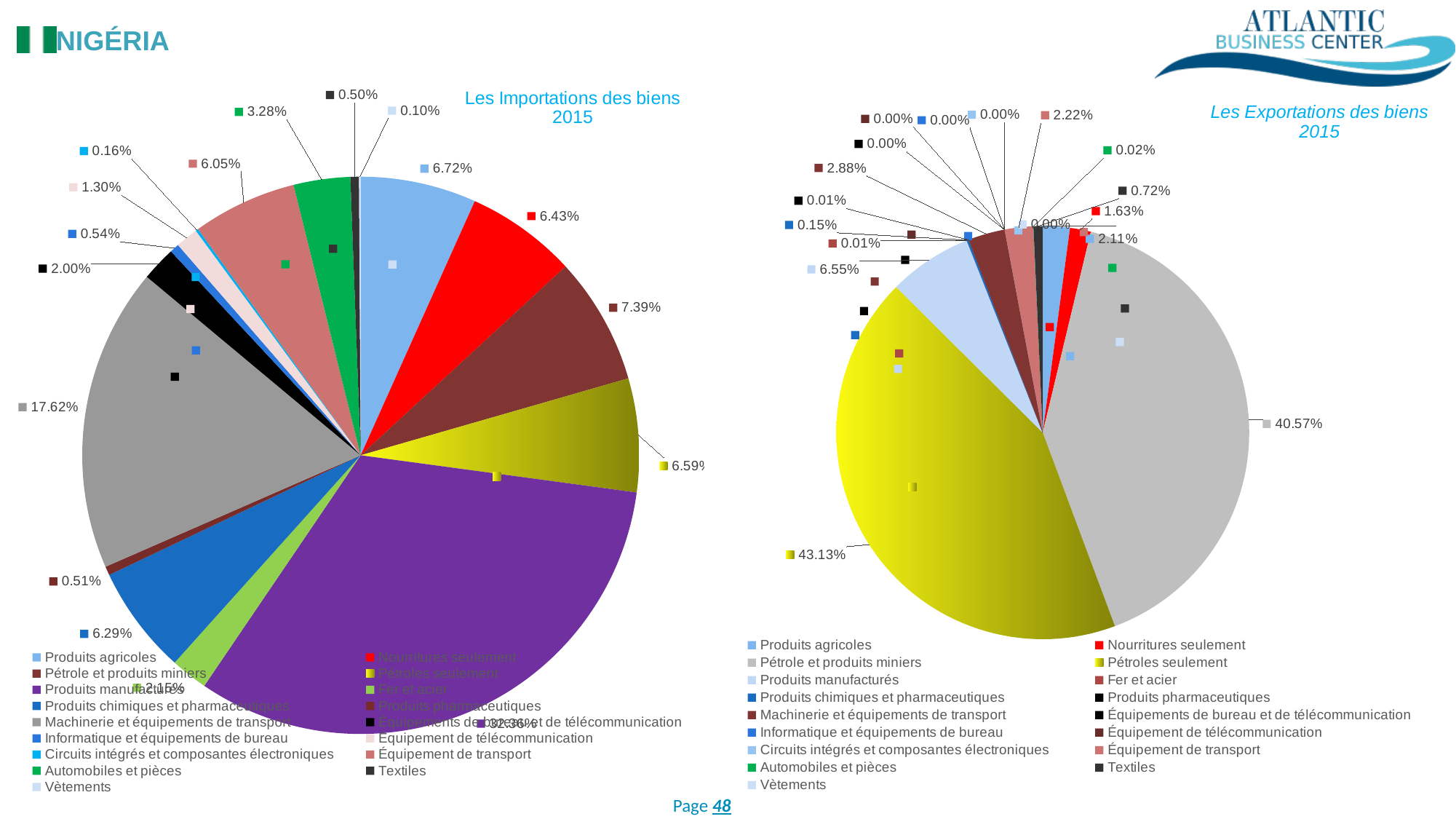
In the 'Les Exportations des biens 2015' chart, what is the share of Pétroles seulement? 43.13% In the 'Les Importations des biens 2015' chart, what is the share of Automobiles et pièces? 3.28% In the 'Les Exportations des biens 2015' chart, which category has the largest share? Pétroles seulement In the 'Les Exportations des biens 2015' chart, what is the difference between the shares of Pétroles seulement and Pétrole et produits miniers? 2.56% In the 'Les Importations des biens 2015' chart, which category has the largest share? Produits manufacturés In the 'Les Exportations des biens 2015' chart, what is the share of Produits manufacturés? 6.55% In the 'Les Importations des biens 2015' chart, what is the share of Machinerie et équipements de transport? 17.62% In the 'Les Importations des biens 2015' chart, what is the share of Pétrole et produits miniers? 7.39% In the 'Les Importations des biens 2015' chart, which is larger: Produits agricoles or Nourritures seulement? Produits agricoles In the 'Les Exportations des biens 2015' chart, what is the share of Pétrole et produits miniers? 40.57% What type of chart is used for 'Les Importations des biens 2015'? pie chart How many categories does the legend of the 'Les Exportations des biens 2015' chart list? 17